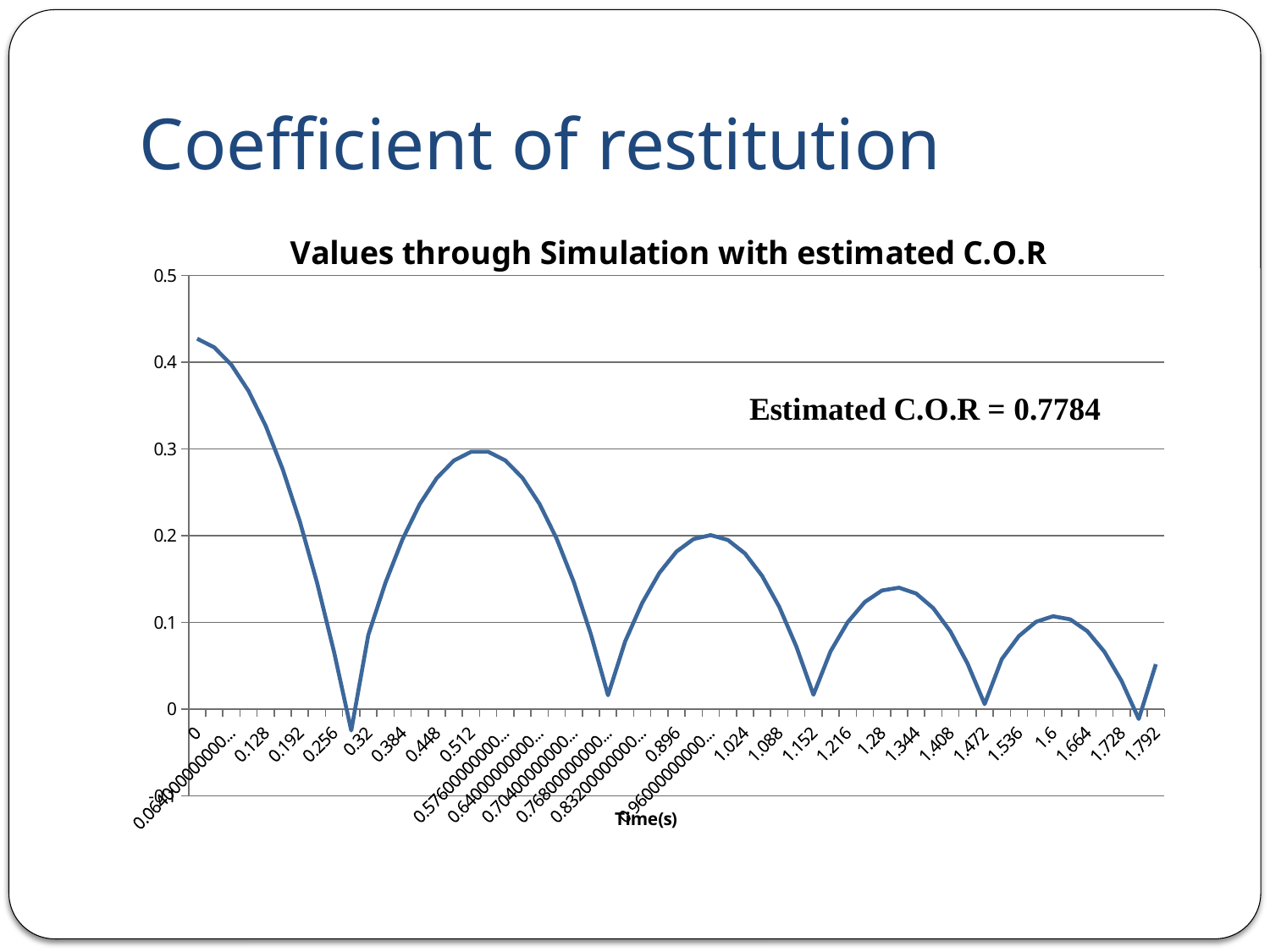
What is the title of the chart? Values through Simulation with estimated C.O.R Is the peak of the line near time 1.6 greater or less than 0.2? less Is the value at time 0 greater or less than 0.4? greater What kind of chart is shown on the slide? line chart Is the value at time 1.792 greater or less than 0.1? less Do the successive peaks of the line rise or fall as time increases? fall What estimated C.O.R value is printed on the chart? 0.7784 Which is larger: the peak near time 0.512 or the peak near time 0.96? the peak near 0.512 Which is larger: the value at time 0 or the value at time 1.792? the value at time 0